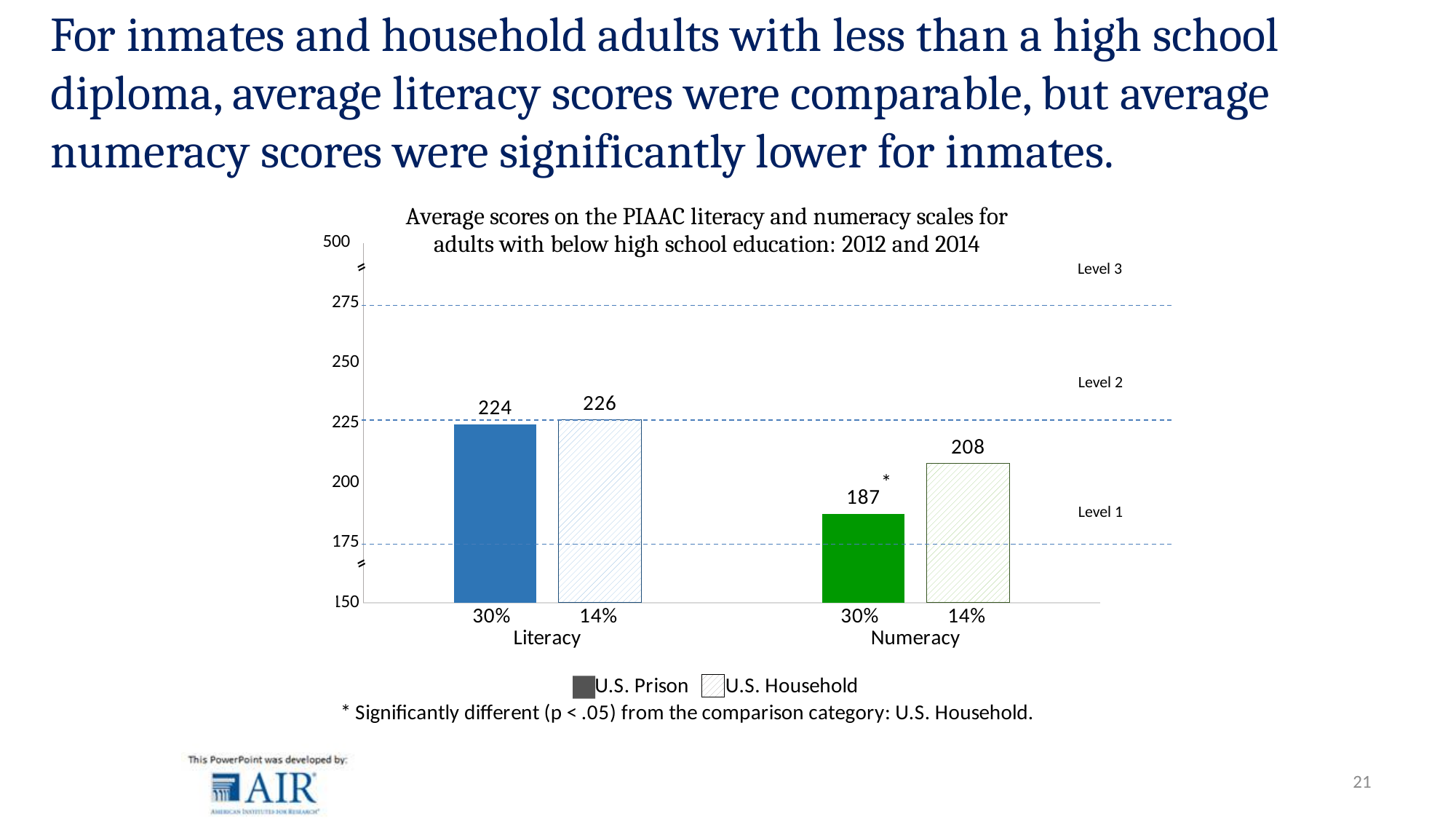
Is the U.S. Prison numeracy score greater or less than 200? less Which is larger, the U.S. Prison numeracy score or the U.S. Household numeracy score? U.S. Household What is the average numeracy score for U.S. Household adults with below high school education? 208 Which bar shows the lowest average score on the chart? U.S. Prison, Numeracy What is the average literacy score for U.S. Household adults? 226 What is the difference between the U.S. Household and U.S. Prison average numeracy scores? 21 What kind of chart is shown on the slide? bar chart What percentage label appears under the U.S. Household bars? 14% What is the average numeracy score for U.S. Prison adults? 187 How many series does the legend list? 2 What is the average literacy score for U.S. Prison adults with below high school education? 224 What is the difference between the U.S. Household and U.S. Prison average literacy scores? 2